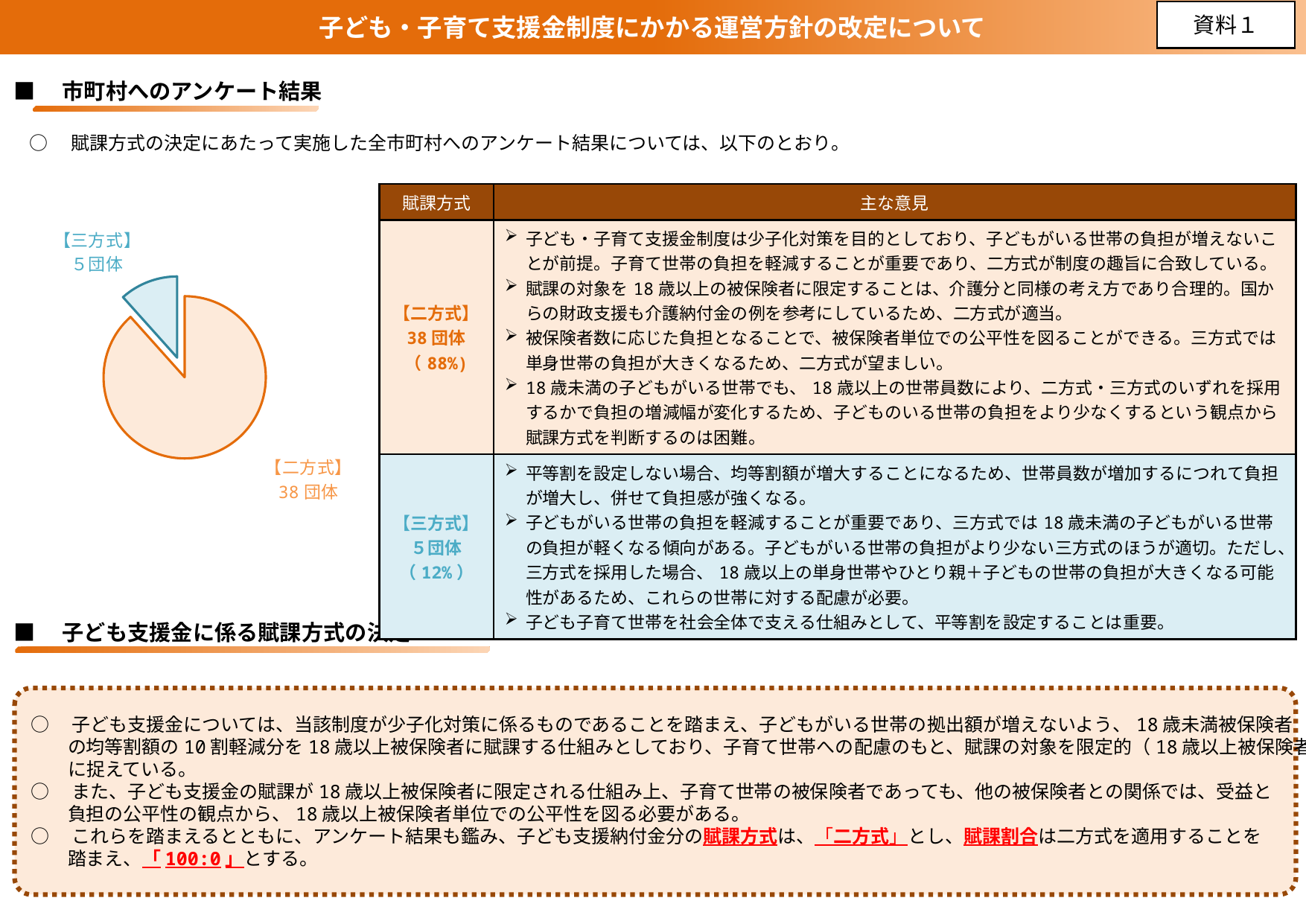
円グラフで最も団体数が多い賦課方式はどれですか。 二方式 円グラフにはいくつの区分（スライス）がありますか。 2 円グラフで三方式が占める割合は何％ですか。 12% 円グラフで最も団体数が少ない賦課方式はどれですか。 三方式 円グラフで【三方式】のスライスは何色で表示されていますか。 水色 円グラフで【三方式】の団体数はいくつですか。 5団体 円グラフで二方式と三方式ではどちらの団体数が多いですか。 二方式 円グラフで【二方式】の団体数はいくつですか。 38団体 円グラフで二方式と三方式の団体数の差はいくつですか。 33団体 このスライドのグラフはどの種類のグラフですか。 円グラフ 円グラフの二方式と三方式の団体数の合計はいくつですか。 43団体 円グラフで二方式が占める割合は何％ですか。 88%